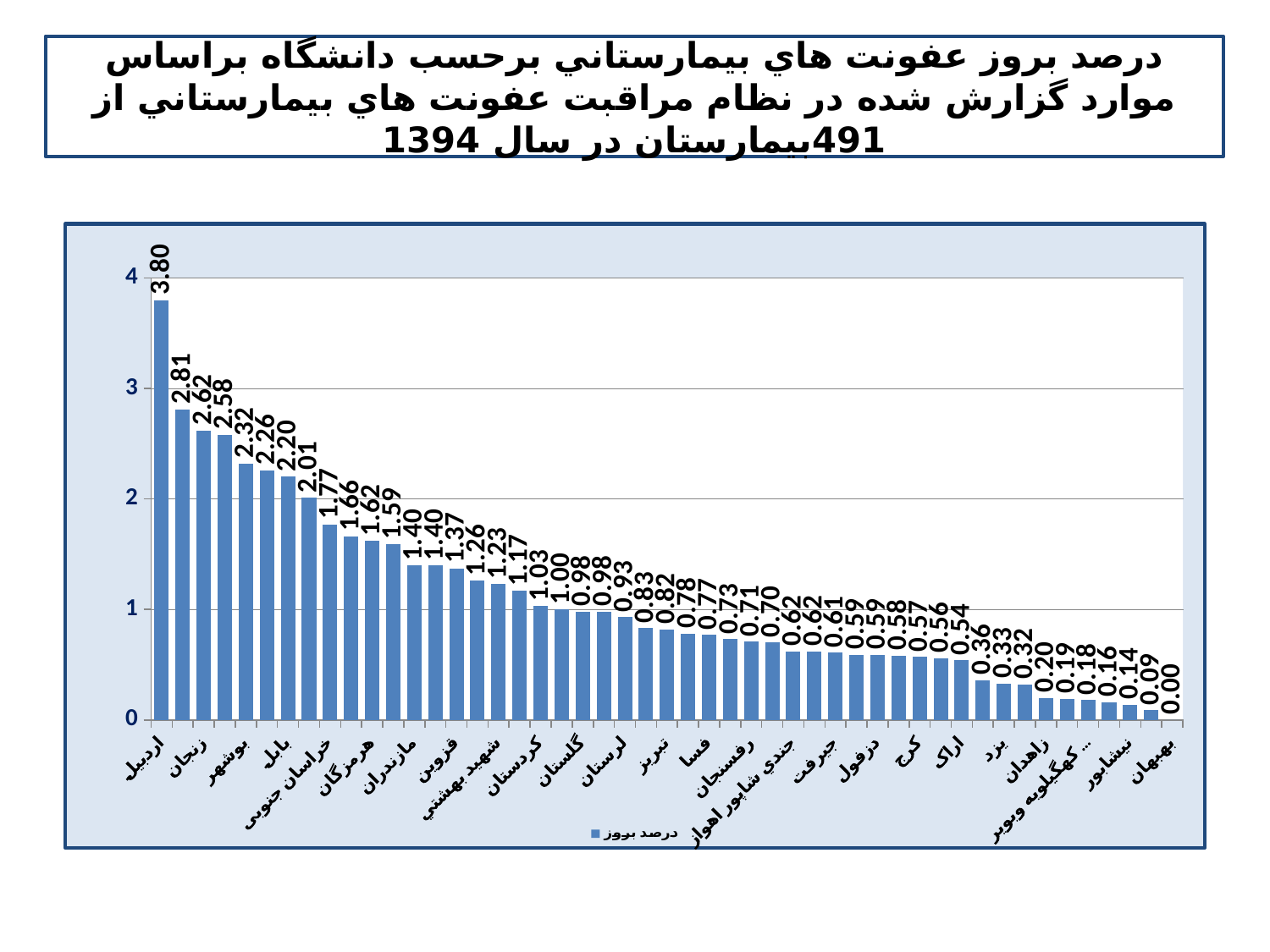
Which has a larger value, اردبیل or قزوین? اردبیل What is the name of the series shown in the legend? درصد بروز Do the values rise or fall moving from left to right along the x axis? fall How many series does the legend list? 1 What is the incidence percentage for اردبیل? 3.80 What is the difference between the values for اردبیل and بهبهان? 3.80 What is the incidence percentage for بهبهان? 0.00 What type of chart is shown on the slide? bar chart Which has a larger value, زنجان or بهبهان? زنجان Is the value for اردبیل greater or less than 3? greater Which university has the lowest incidence percentage in the chart? بهبهان Which university has the highest incidence percentage in the chart? اردبیل